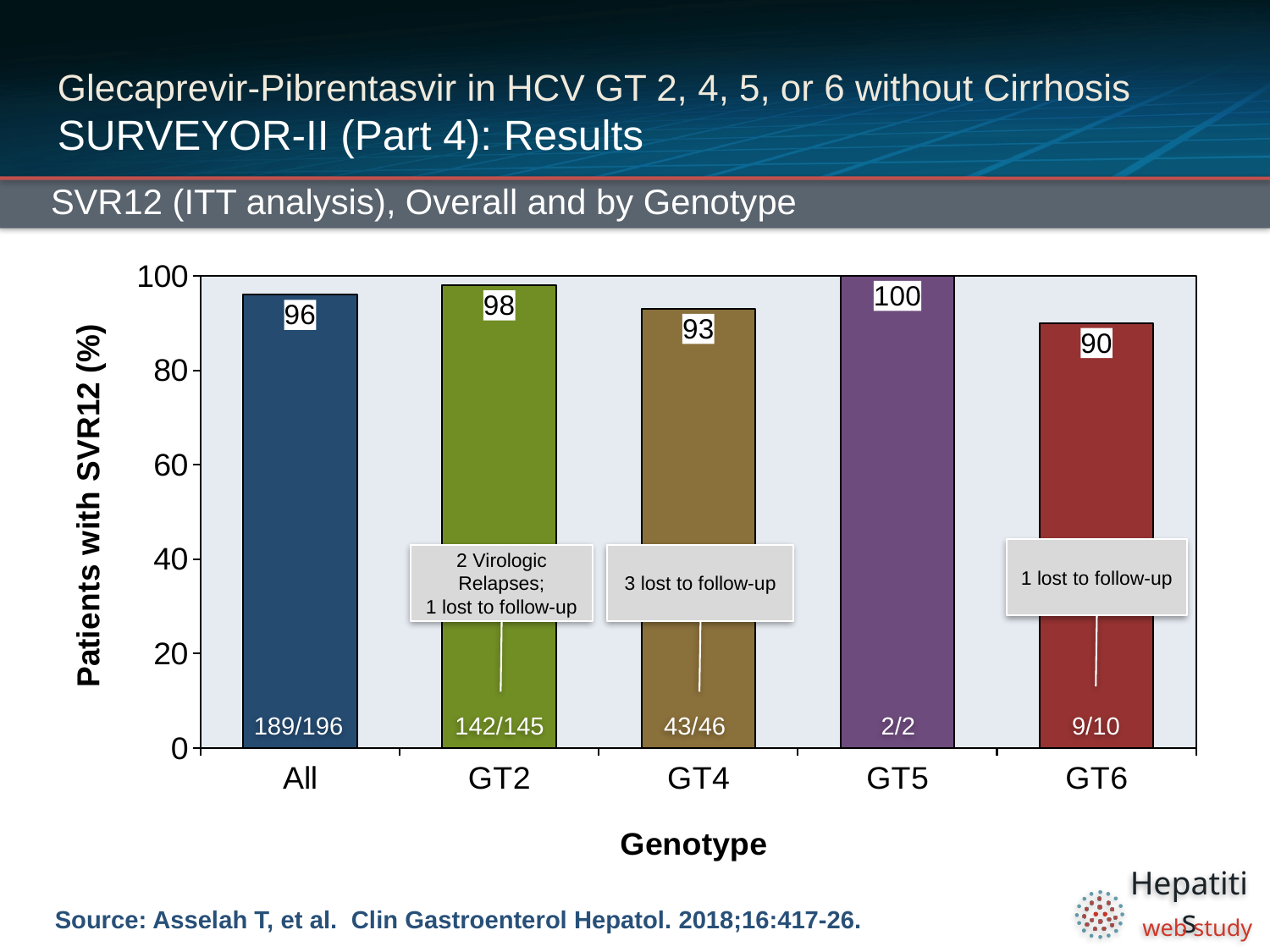
Which genotype has the lowest SVR12 rate? GT6 What is the SVR12 rate for the All group? 96 What is the SVR12 rate for GT2? 98 How many patients achieved SVR12 in the GT4 group, as shown at the base of the bar? 43/46 What kind of chart is shown on the slide? Bar chart What is the difference in SVR12 rate between GT2 and GT4? 5 How many categories are shown on the x axis? 5 Is the SVR12 rate for GT6 greater or less than 80? greater What is the label of the y axis? Patients with SVR12 (%) Which has a higher SVR12 rate, GT4 or GT6? GT4 Which genotype has the highest SVR12 rate? GT5 What is the SVR12 rate for GT6? 90